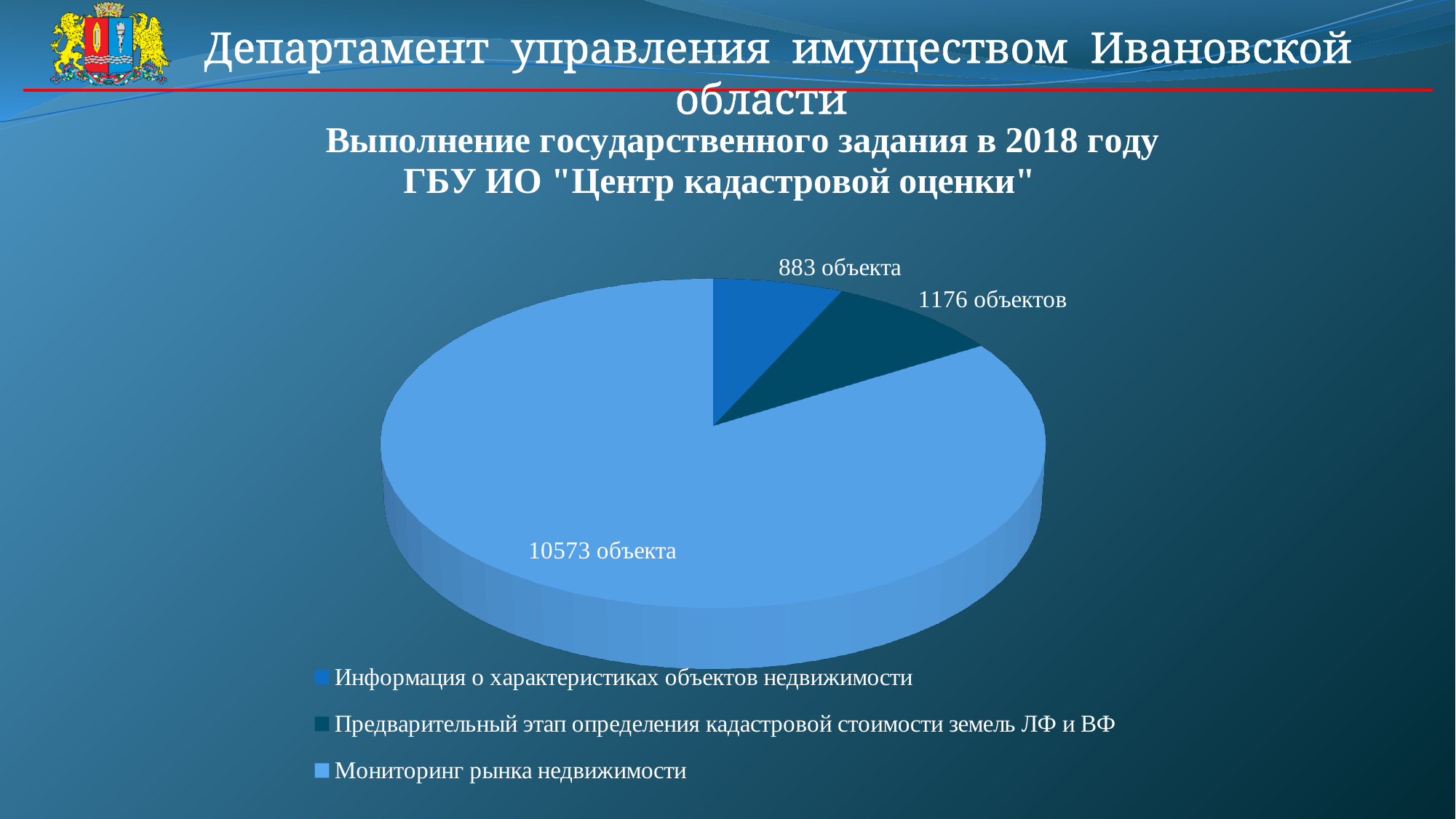
What is the difference between the values for "Предварительный этап определения кадастровой стоимости земель ЛФ и ВФ" and "Информация о характеристиках объектов недвижимости"? 293 What kind of chart is shown on the slide? Pie chart What value is shown for the slice "Предварительный этап определения кадастровой стоимости земель ЛФ и ВФ"? 1176 объектов Which is larger: the value for "Мониторинг рынка недвижимости" or the value for "Предварительный этап определения кадастровой стоимости земель ЛФ и ВФ"? Мониторинг рынка недвижимости Which category has the largest slice of the pie chart? Мониторинг рынка недвижимости How many slices does the pie chart have? 3 What value is shown for the slice "Мониторинг рынка недвижимости"? 10573 объекта What is the title of the chart on the slide? Выполнение государственного задания в 2018 году ГБУ ИО "Центр кадастровой оценки" What is the total of all three slices in the pie chart? 12632 What value is shown for the slice "Информация о характеристиках объектов недвижимости"? 883 объекта Which category has the smallest slice of the pie chart? Информация о характеристиках объектов недвижимости How many entries does the legend of the pie chart list? 3